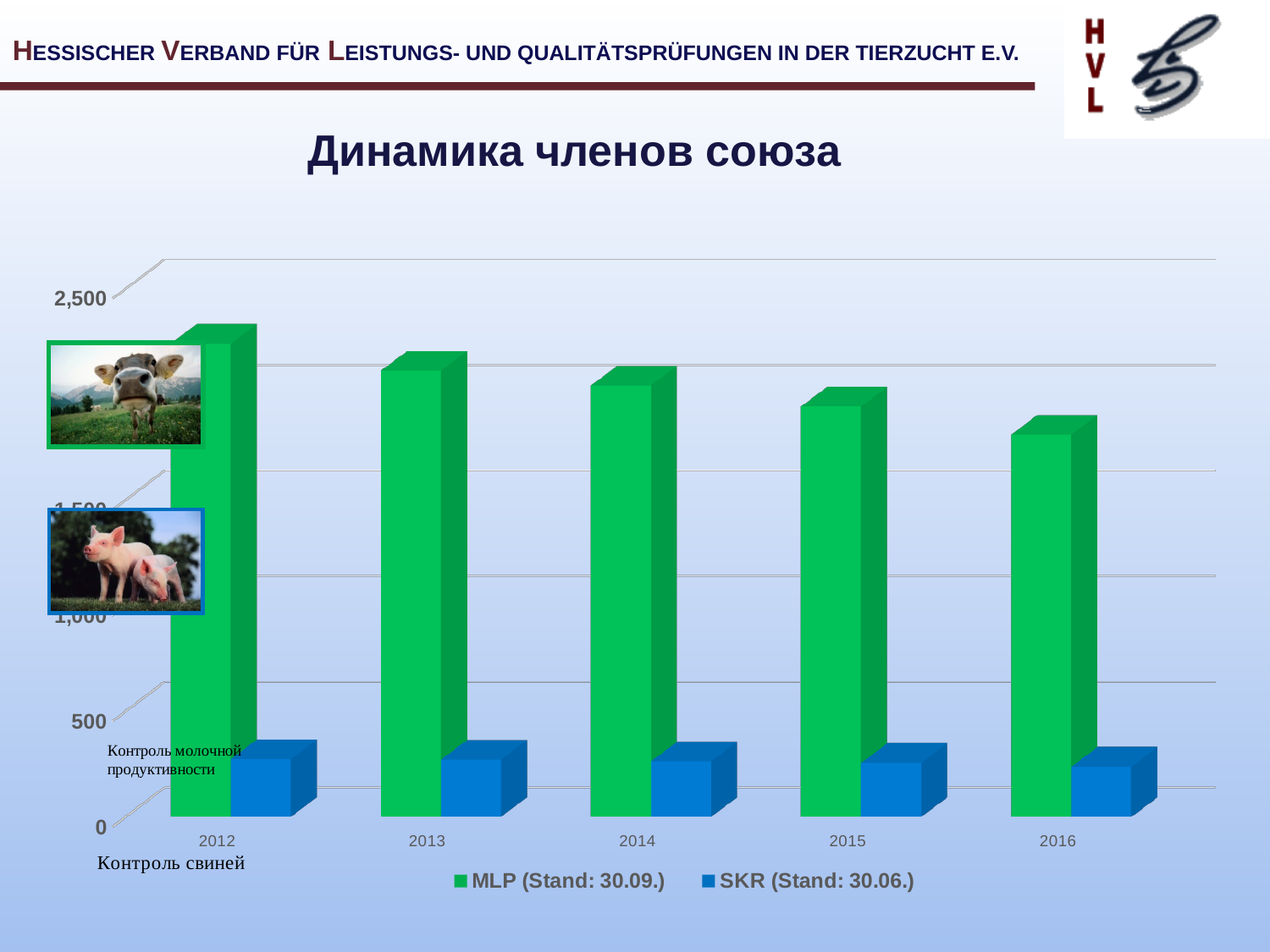
Do the MLP (Stand: 30.09.) values rise or fall from 2012 to 2016? fall Which series is shown in blue in the chart? SKR (Stand: 30.06.) Is the MLP (Stand: 30.09.) value for 2016 greater or less than 1,500? greater What is the title of the chart? Динамика членов союза How many series does the chart legend list? 2 How many years are shown on the x axis of the chart? 5 Is the MLP (Stand: 30.09.) value for 2012 greater or less than 2,500? less In which year is the MLP (Stand: 30.09.) value highest? 2012 In which year is the MLP (Stand: 30.09.) value lowest? 2016 In 2012, which series has the larger value, MLP (Stand: 30.09.) or SKR (Stand: 30.06.)? MLP (Stand: 30.09.) Is the SKR (Stand: 30.06.) value for 2012 greater or less than 500? less What kind of chart is shown on the slide? bar chart